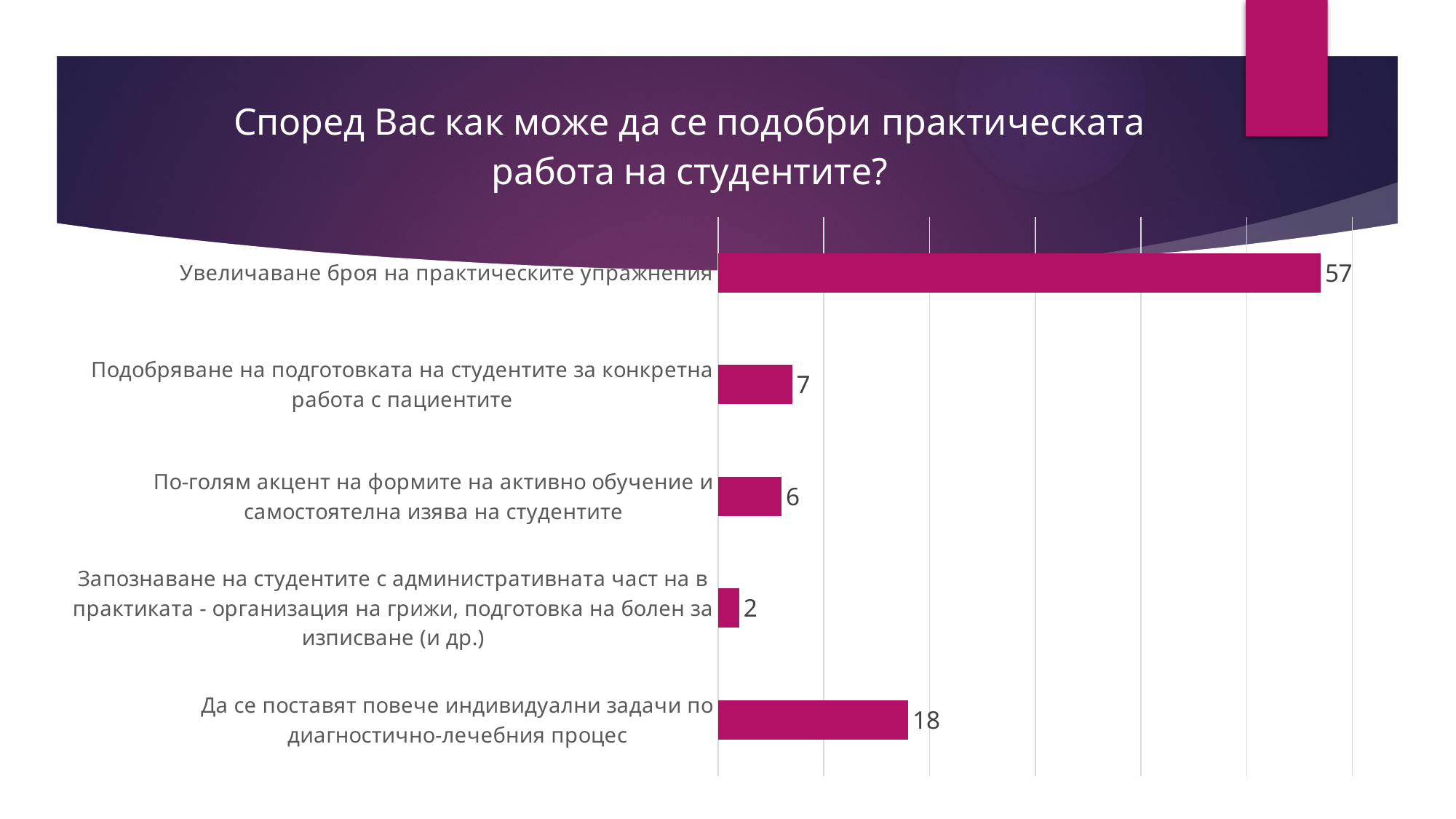
Which category has the lowest value? Запознаване на студентите с административната част на в практиката - организация на грижи, подготовка на болен за изписване (и др.) What is the value for "Подобряване на подготовката на студентите за конкретна работа с пациентите"? 7 What is the value for "Да се поставят повече индивидуални задачи по диагностично-лечебния процес"? 18 What is the difference between the values for "Увеличаване броя на практическите упражнения" and "Да се поставят повече индивидуални задачи по диагностично-лечебния процес"? 39 How many categories are shown in the chart? 5 Which category has the highest value? Увеличаване броя на практическите упражнения Which is larger: the value for "Подобряване на подготовката на студентите за конкретна работа с пациентите" or the value for "Да се поставят повече индивидуални задачи по диагностично-лечебния процес"? Да се поставят повече индивидуални задачи по диагностично-лечебния процес What is the value for "Запознаване на студентите с административната част на в практиката - организация на грижи, подготовка на болен за изписване (и др.)"? 2 What is the value for "Увеличаване броя на практическите упражнения"? 57 What kind of chart is shown on the slide? Bar chart What is the title of the slide? Според Вас как може да се подобри практическата работа на студентите? What is the value for "По-голям акцент на формите на активно обучение и самостоятелна изява на студентите"? 6